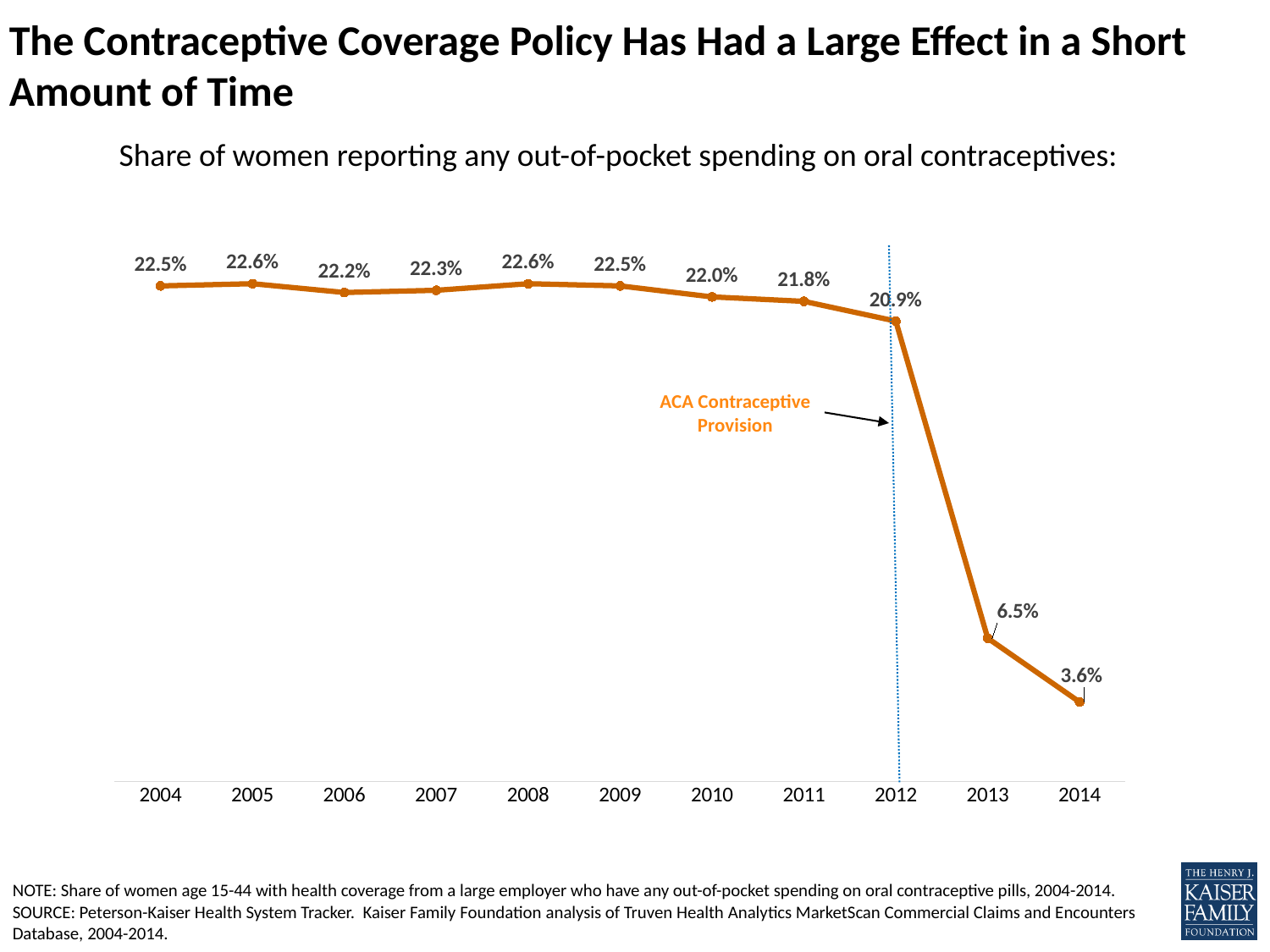
What is the difference between the 2012 value and the 2013 value? 14.4 percentage points What event does the dotted vertical line on the chart mark? ACA Contraceptive Provision What value is shown for 2013? 6.5% Which year has the larger value, 2011 or 2013? 2011 What is the difference between the 2004 value and the 2014 value? 18.9 percentage points Which year has the lowest share of women reporting any out-of-pocket spending on oral contraceptives? 2014 In which year does the dotted vertical line marking the ACA Contraceptive Provision appear? 2012 What was the share of women reporting any out-of-pocket spending on oral contraceptives in 2012? 20.9% What share of women reported any out-of-pocket spending on oral contraceptives in 2014? 3.6% What kind of chart is shown on the slide? Line chart How many years are plotted on the chart? 11 Does the share of women reporting any out-of-pocket spending rise or fall from 2012 to 2014? Fall